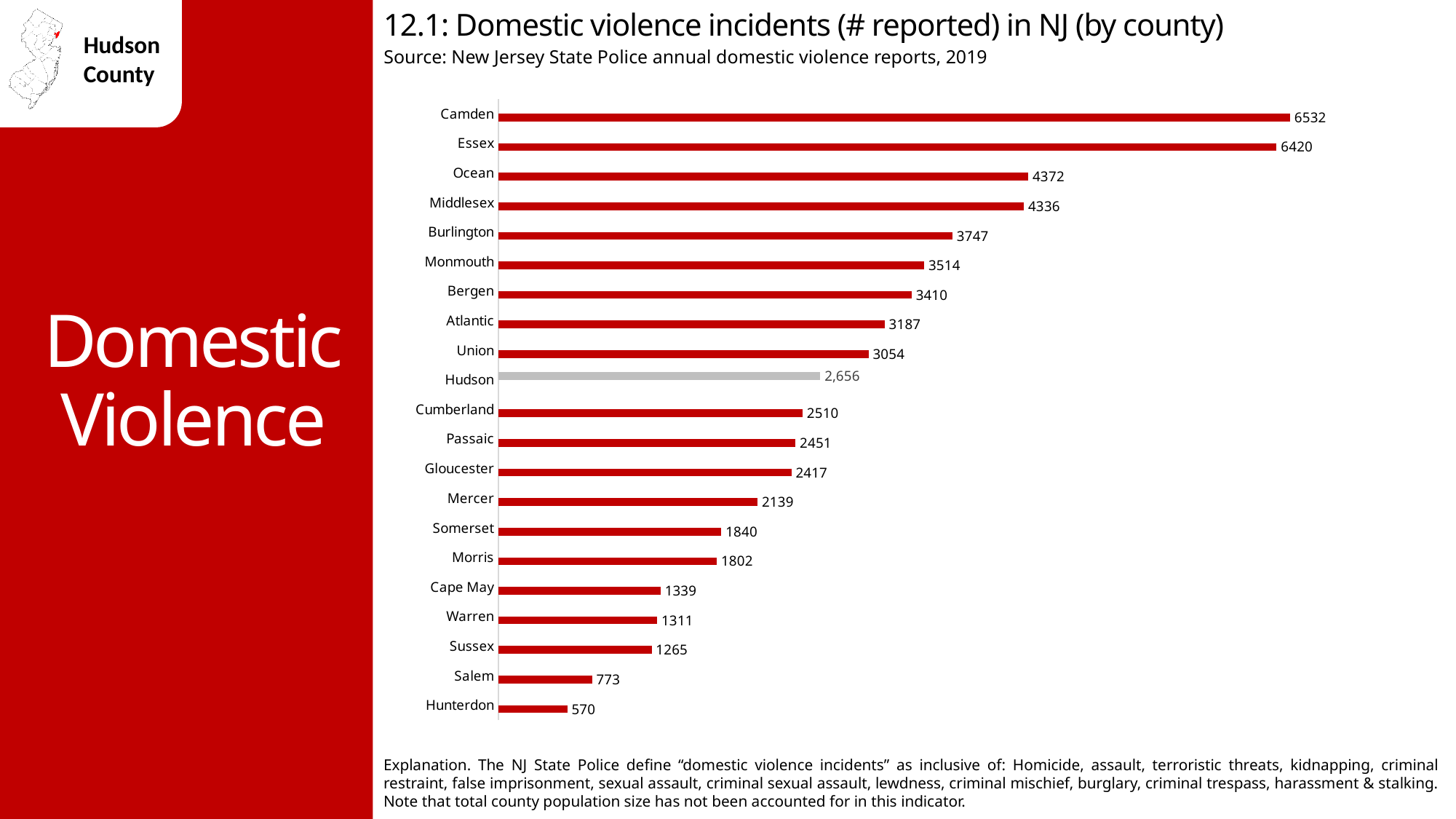
What is the number of reported domestic violence incidents for Hudson County? 2,656 What is the difference between the number of incidents in Camden and Essex? 112 What is the number of reported domestic violence incidents for Mercer County? 2139 What is the number of reported domestic violence incidents for Camden County? 6532 Which county has the lowest number of reported domestic violence incidents? Hunterdon Which county's bar is shown in gray instead of red? Hudson Which county has the highest number of reported domestic violence incidents? Camden How many counties are shown in the chart? 21 What is the difference between the number of incidents in Hudson and Cumberland? 146 Which county has more reported incidents, Ocean or Bergen? Ocean Which county has more reported incidents, Salem or Sussex? Sussex What kind of chart is used to show domestic violence incidents by county? Bar chart